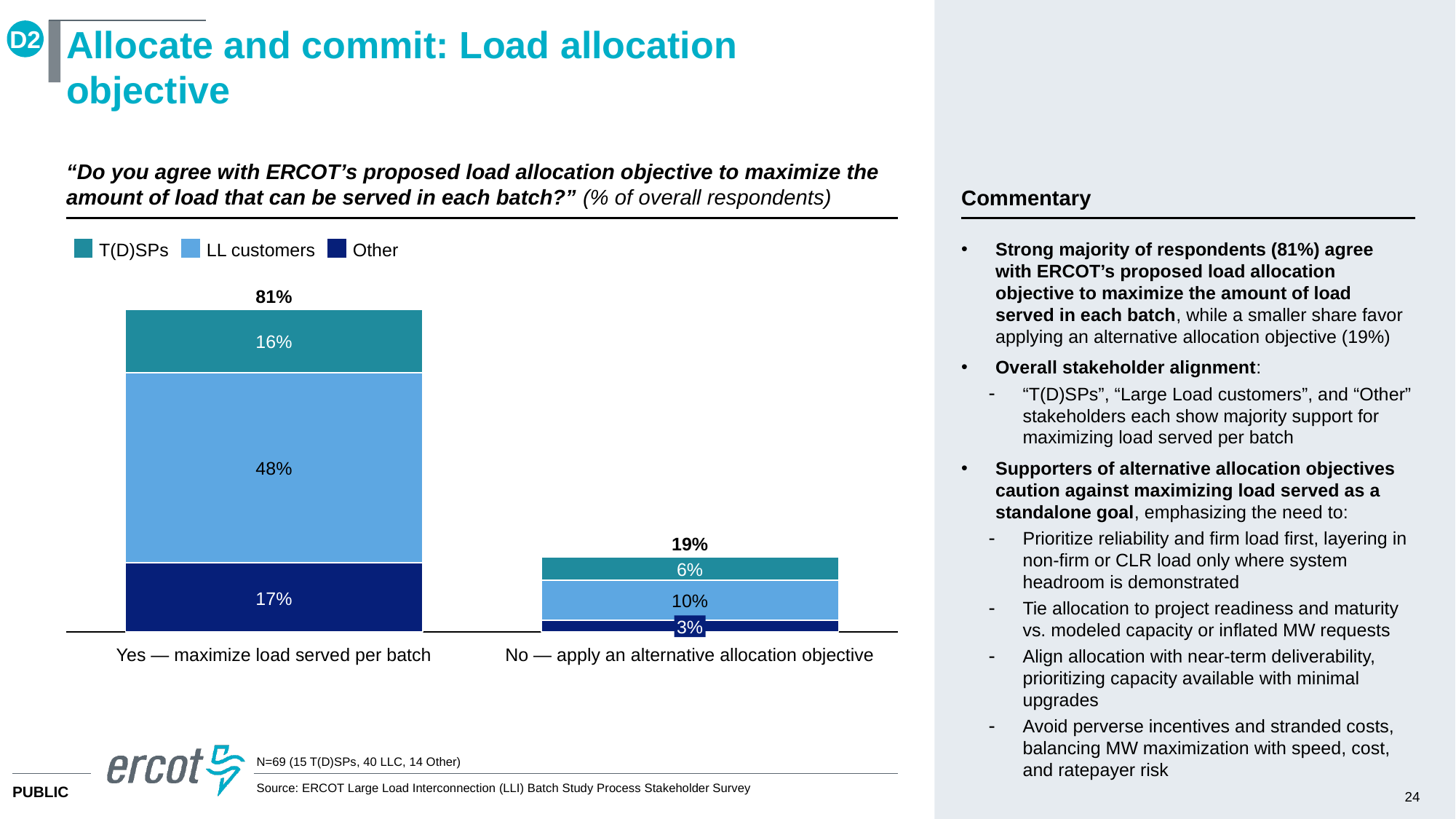
How many categories are shown on the x axis? 2 How many series does the legend list? 3 What is the Other value for 'Yes — maximize load served per batch'? 17% What is the difference between the T(D)SPs values for the Yes and No bars? 10% What is the Other value for 'No — apply an alternative allocation objective'? 3% What is the total for the 'No — apply an alternative allocation objective' bar? 19% Which series has the largest segment in the 'Yes — maximize load served per batch' bar? LL customers Which bar has the higher total, Yes or No? Yes — maximize load served per batch What kind of chart is shown on the slide? Stacked bar chart What is the total for the 'Yes — maximize load served per batch' bar? 81% What is the LL customers value for 'Yes — maximize load served per batch'? 48% What is the T(D)SPs value for 'No — apply an alternative allocation objective'? 6%